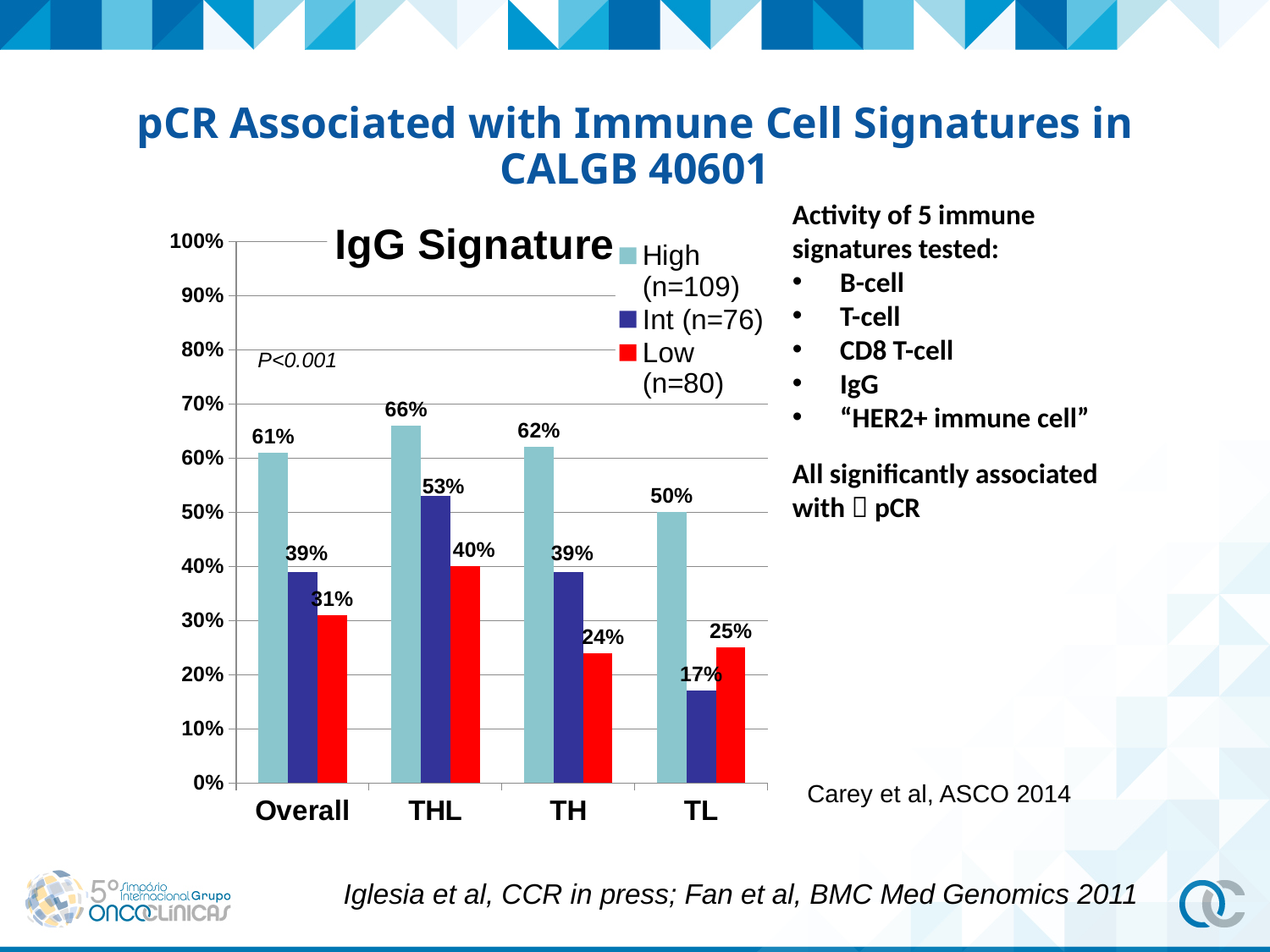
What is the value for the Low (n=80) series in the Overall category? 31% What is the value for the Int (n=76) series in the TL category? 17% What is the title of the chart? IgG Signature What kind of chart is shown on the slide? bar chart Which category has the highest value for the High (n=109) series? THL Is the value for High (n=109) in the Overall category greater or less than 50%? greater What is the value for the High (n=109) series in the THL category? 66% Which category has the lowest value for the Int (n=76) series? TL How many categories are shown on the x axis? 4 How many series does the legend list? 3 What is the difference between the High and Low values in the TH category? 38% Which is larger in the TL category, the Int (n=76) value or the Low (n=80) value? Low (n=80)